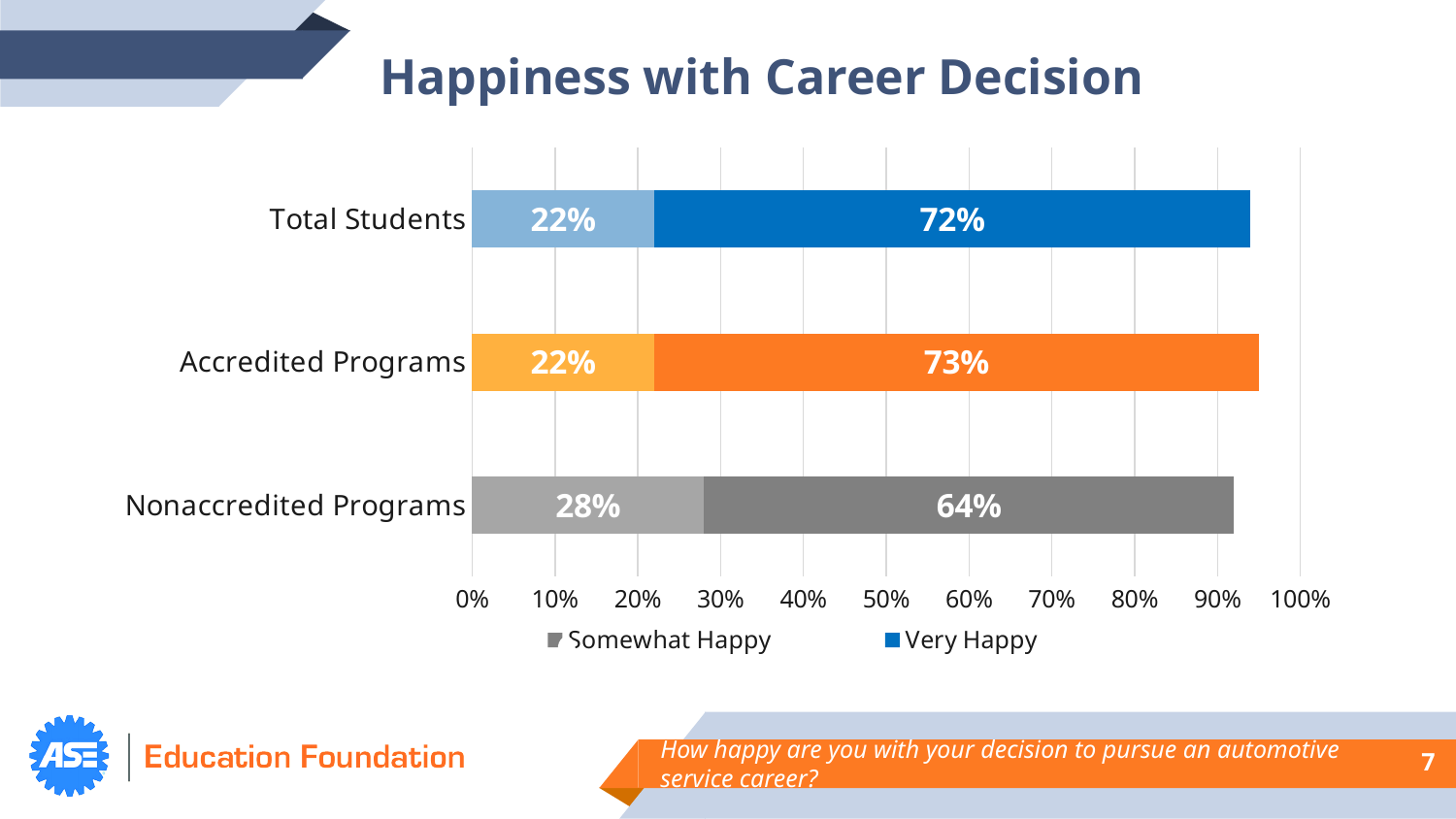
Which category has the highest Very Happy value? Accredited Programs How many series does the legend list? 2 What is the difference between the Very Happy values for Accredited Programs and Nonaccredited Programs? 9% How many categories are shown on the chart? 3 Which is larger: the Somewhat Happy value for Nonaccredited Programs or for Accredited Programs? Nonaccredited Programs What is the Very Happy value for Total Students? 72% What kind of chart is shown on the slide? Stacked bar chart What is the Very Happy value for Accredited Programs? 73% What is the combined total of Somewhat Happy and Very Happy for Nonaccredited Programs? 92% What is the Somewhat Happy value for Nonaccredited Programs? 28% Which category has the lowest Very Happy value? Nonaccredited Programs What is the combined total of Somewhat Happy and Very Happy for Accredited Programs? 95%